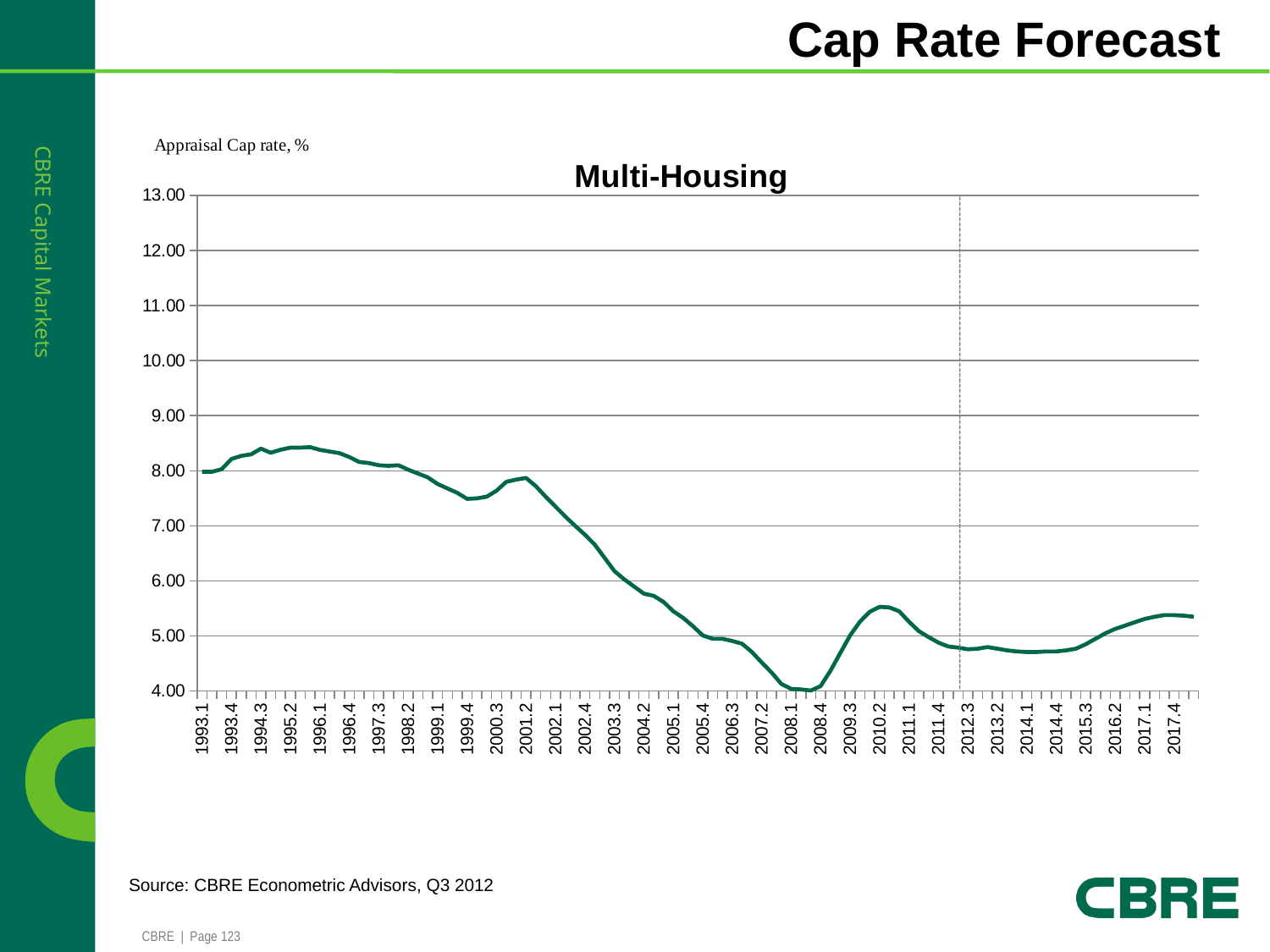
What kind of chart is shown on the slide? line chart In which year does the line reach its lowest point? 2008 Does the line rise or fall between 2001.2 and 2008.1? fall What quantity does the chart plot, according to the label above the y axis? Appraisal Cap rate, % Is the value for 2017.4 greater or less than 6.00? less Is the value for 2010.2 greater or less than 5.00? greater Does the line rise or fall between 2012.3 and 2017.4? rise How many lines (series) are plotted on the chart? 1 Which is larger, the value for 1995.2 or the value for 2005.4? 1995.2 Is the value for 2002.4 greater or less than 7.00? less What is the title of the chart? Multi-Housing